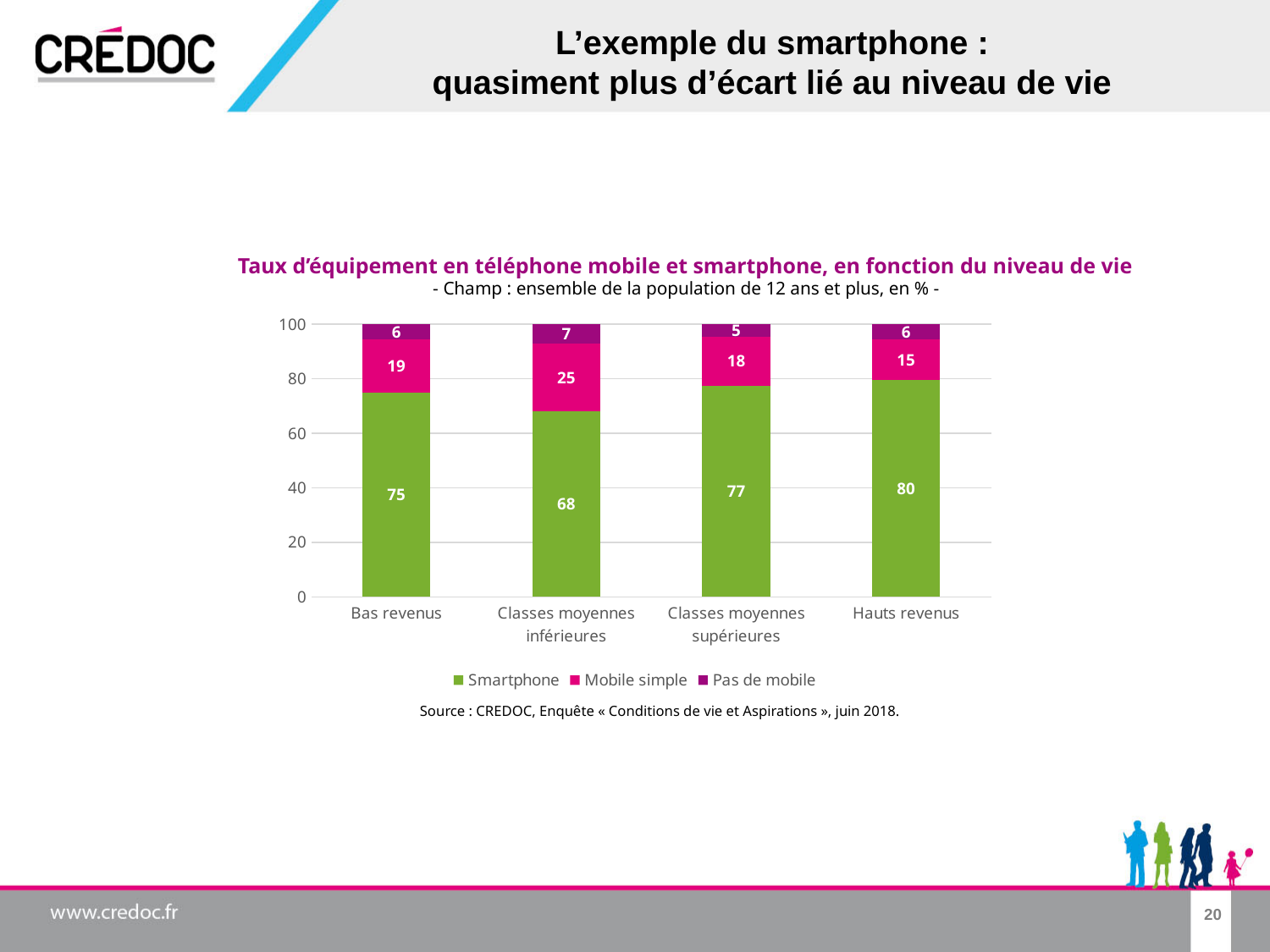
What is the total of the stacked bar for Bas revenus? 100 Which is larger: the Mobile simple value for Bas revenus or for Hauts revenus? Bas revenus What kind of chart is shown? Stacked bar chart What is the difference between the Smartphone values for Hauts revenus and Classes moyennes inférieures? 12 Which category has the highest Smartphone value? Hauts revenus What is the Smartphone value for Hauts revenus? 80 Which series is shown in green? Smartphone How many categories are shown on the x axis? 4 Which category has the lowest Smartphone value? Classes moyennes inférieures What is the Mobile simple value for Classes moyennes inférieures? 25 What is the Pas de mobile value for Classes moyennes supérieures? 5 How many series does the legend list? 3